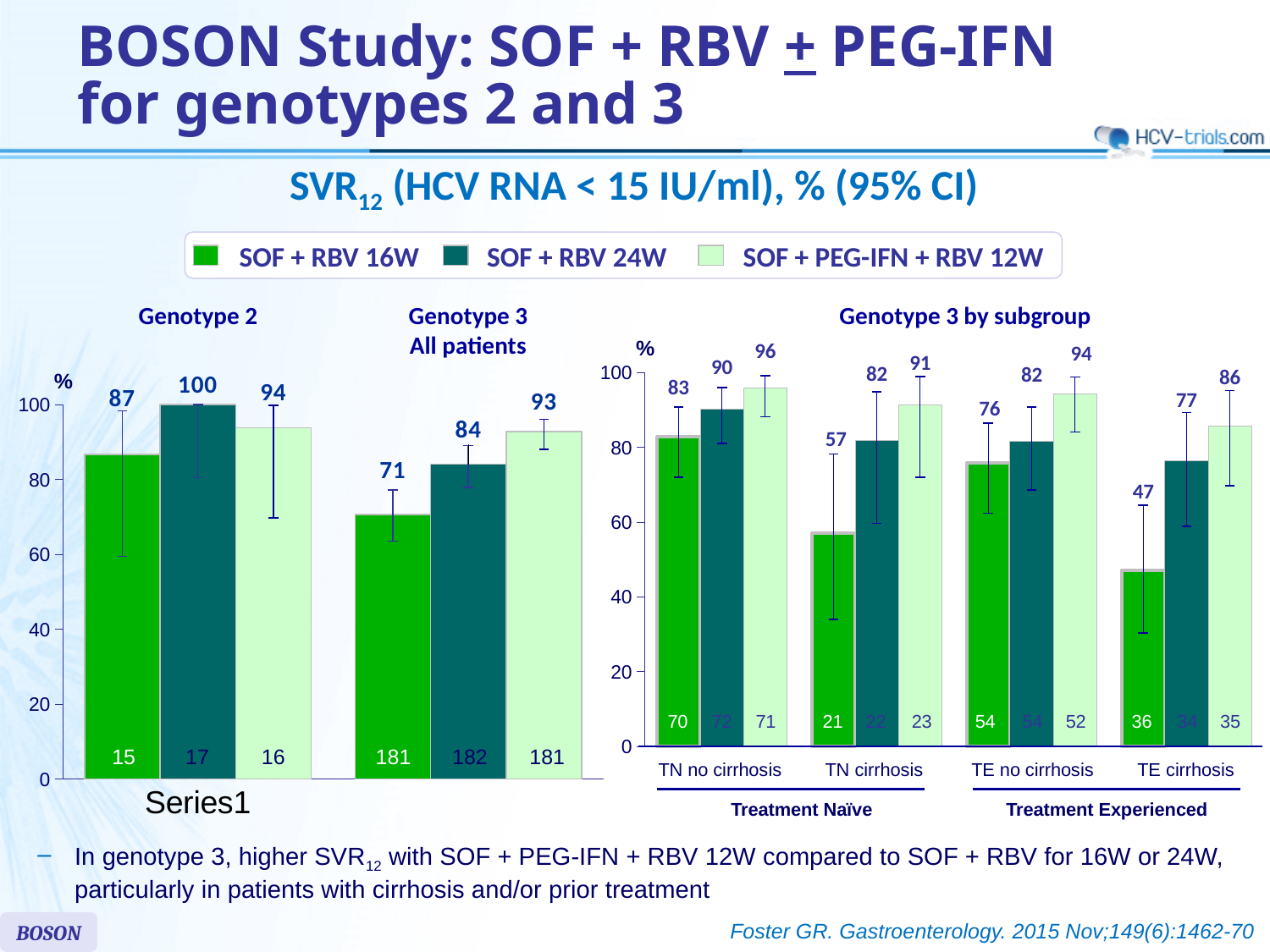
In the Genotype 3 by subgroup chart, which subgroup has the highest SVR12 value for SOF + PEG-IFN + RBV 12W? TN no cirrhosis In the left chart, what is the difference between the SOF + PEG-IFN + RBV 12W and SOF + RBV 16W SVR12 values in Genotype 3 All patients? 22 How many series does the legend list? 3 In the Genotype 3 by subgroup chart, what is the difference between the SOF + RBV 24W and SOF + RBV 16W SVR12 values in TN cirrhosis? 25 In the Genotype 3 by subgroup chart, which subgroup has the lowest SVR12 value for SOF + RBV 16W? TE cirrhosis In the Genotype 3 by subgroup chart, which is larger: the SOF + RBV 24W value in TE no cirrhosis or the SOF + RBV 24W value in TE cirrhosis? TE no cirrhosis In the left chart, what is the SVR12 value for SOF + RBV 16W in Genotype 3 All patients? 71 How many subgroups are shown on the x axis of the Genotype 3 by subgroup chart? 4 In the Genotype 3 by subgroup chart, what is the SVR12 value for SOF + RBV 16W in TE cirrhosis? 47 In the left chart, what is the SVR12 value for SOF + RBV 24W in Genotype 2? 100 In the Genotype 3 by subgroup chart, what is the SVR12 value for SOF + PEG-IFN + RBV 12W in TN no cirrhosis? 96 What kind of chart is the Genotype 3 by subgroup chart? Bar chart